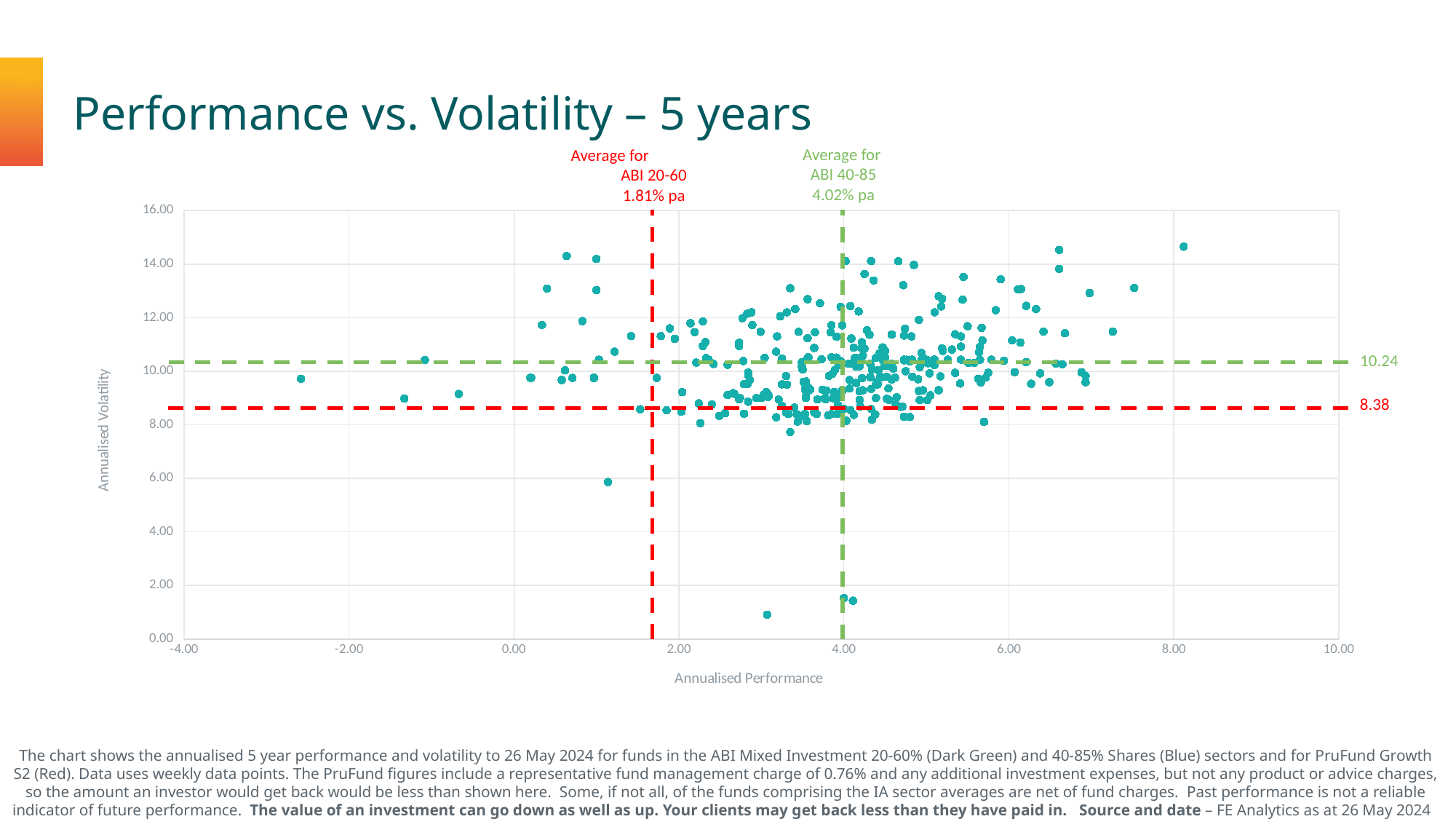
What is the difference between the two labelled horizontal line values, 10.24 and 8.38? 1.86 What is the average annualised performance for ABI 40-85 shown on the chart? 4.02% pa What is the label of the vertical (y) axis of the chart? Annualised Volatility What is the difference between the average annualised performance for ABI 40-85 (4.02% pa) and ABI 20-60 (1.81% pa)? 2.21% pa What kind of chart is shown on the slide? Scatter chart Is the volatility value on the green dashed horizontal line greater or less than 10.00? greater What is the average annualised performance for ABI 20-60 shown on the chart? 1.81% pa What annualised volatility value is labelled on the green dashed horizontal line? 10.24 What annualised volatility value is labelled on the red dashed horizontal line? 8.38 What is the title of the chart on the slide? Performance vs. Volatility – 5 years Is the volatility value on the red dashed horizontal line greater or less than 8.00? greater Which has the higher average annualised performance, ABI 20-60 or ABI 40-85? ABI 40-85